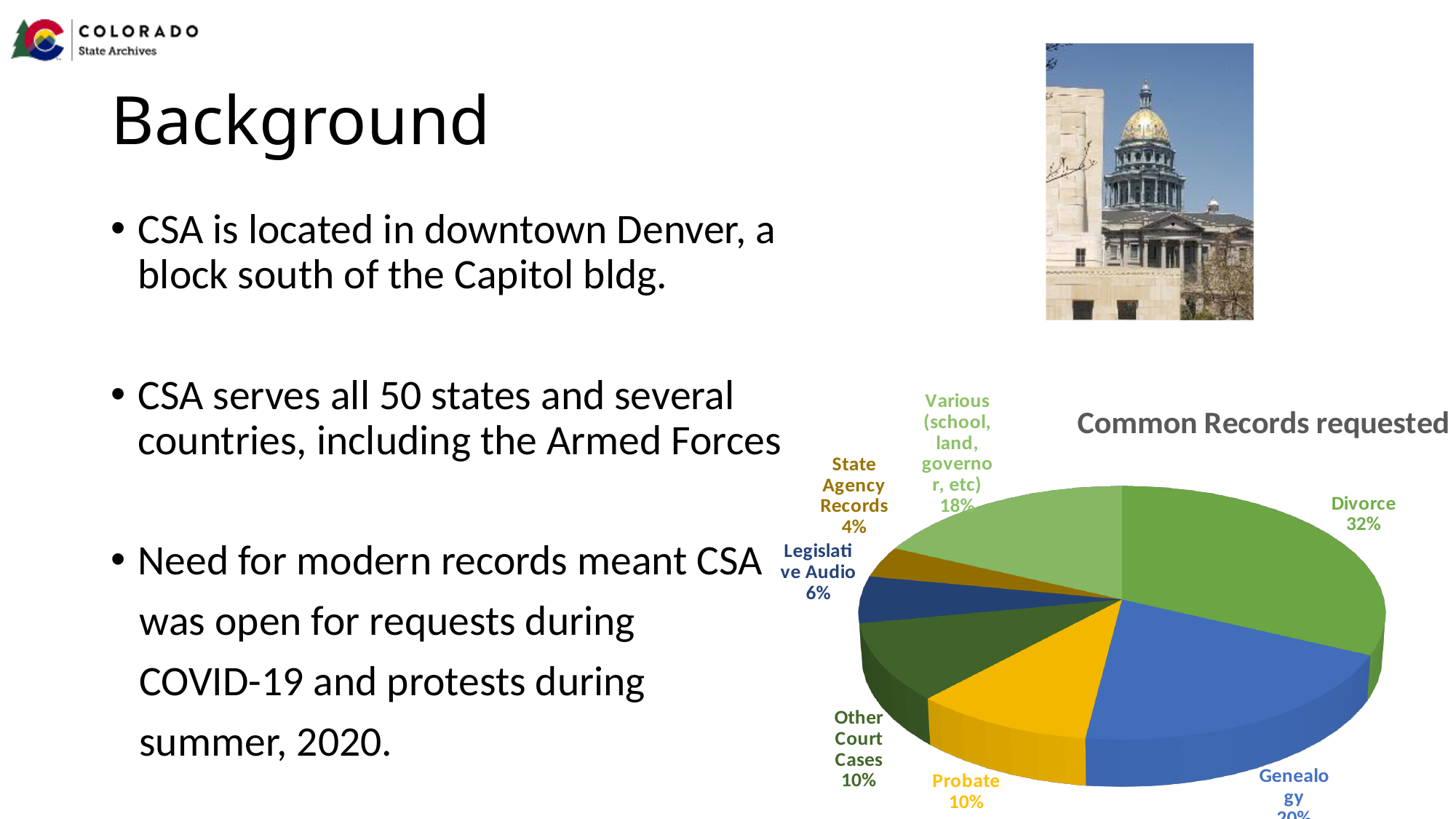
What is the title of the chart? Common Records requested What percentage is shown for Probate? 10% Which category has the largest slice of the pie? Divorce What percentage is shown for Various (school, land, governor, etc)? 18% What kind of chart is shown on the slide? pie chart What percentage is shown for State Agency Records? 4% What is the difference in percentage points between Divorce and Various (school, land, governor, etc)? 14 How many categories are shown in the pie chart? 7 What percentage is shown for Legislative Audio? 6% Which is larger, the Genealogy slice or the Probate slice? Genealogy Which category has the smallest slice of the pie? State Agency Records What share of the pie is Divorce? 32%